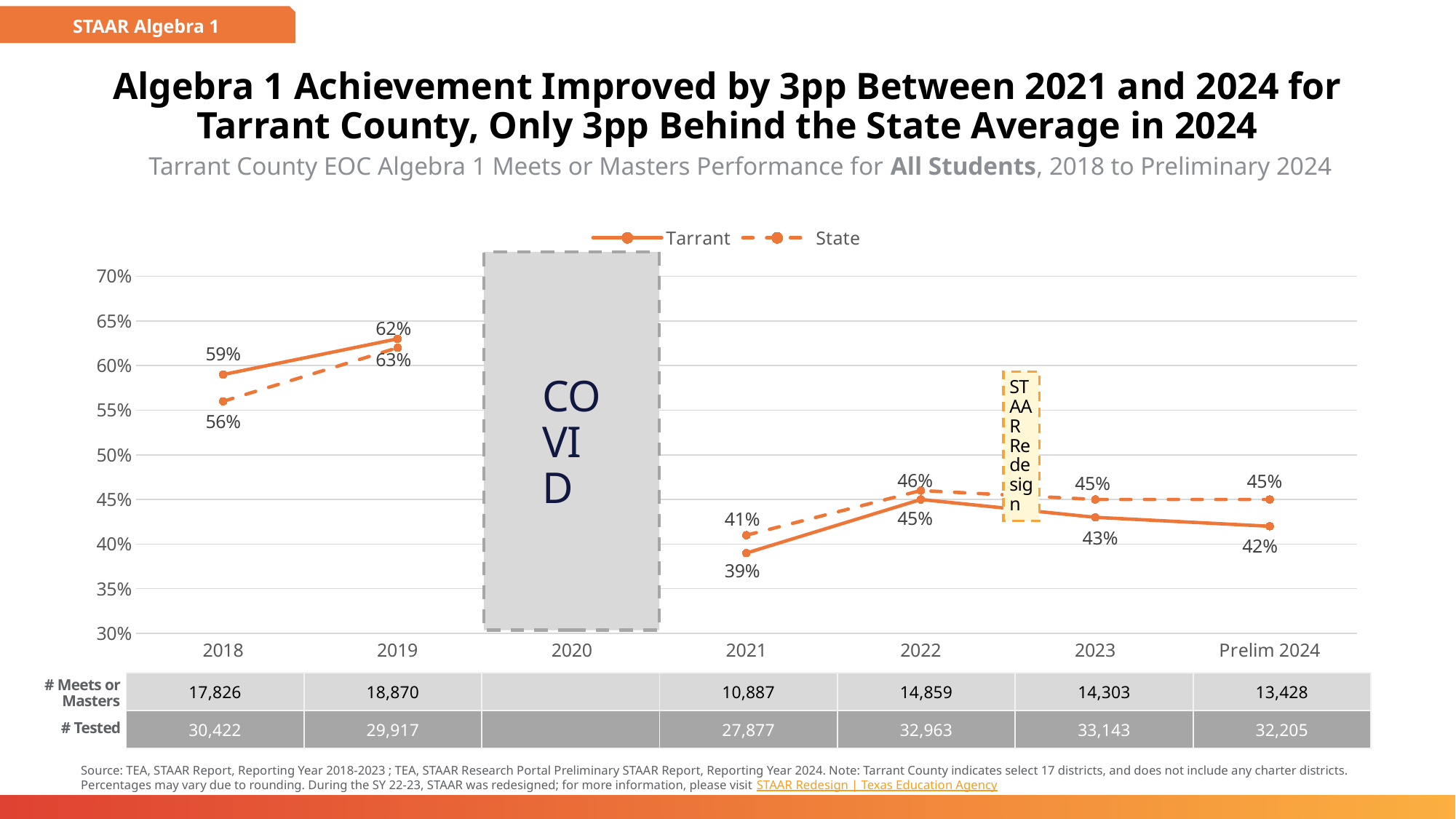
By how many percentage points did the State value exceed the Tarrant value in Prelim 2024? 3 percentage points What was the Tarrant Meets or Masters percentage in 2018? 59% How many series does the chart legend list? 2 What was the Tarrant value in 2021? 39% In 2018, which was higher, Tarrant or State? Tarrant What kind of chart is shown on the slide? Line chart What was the State Meets or Masters percentage in 2018? 56% Did the Tarrant value rise or fall from 2022 to Prelim 2024? Fall What was the Tarrant value for Prelim 2024? 42% How many students were tested in Tarrant County in 2022 according to the table below the chart? 32,963 In which year was the Tarrant value lowest? 2021 What was the State value for Prelim 2024? 45%